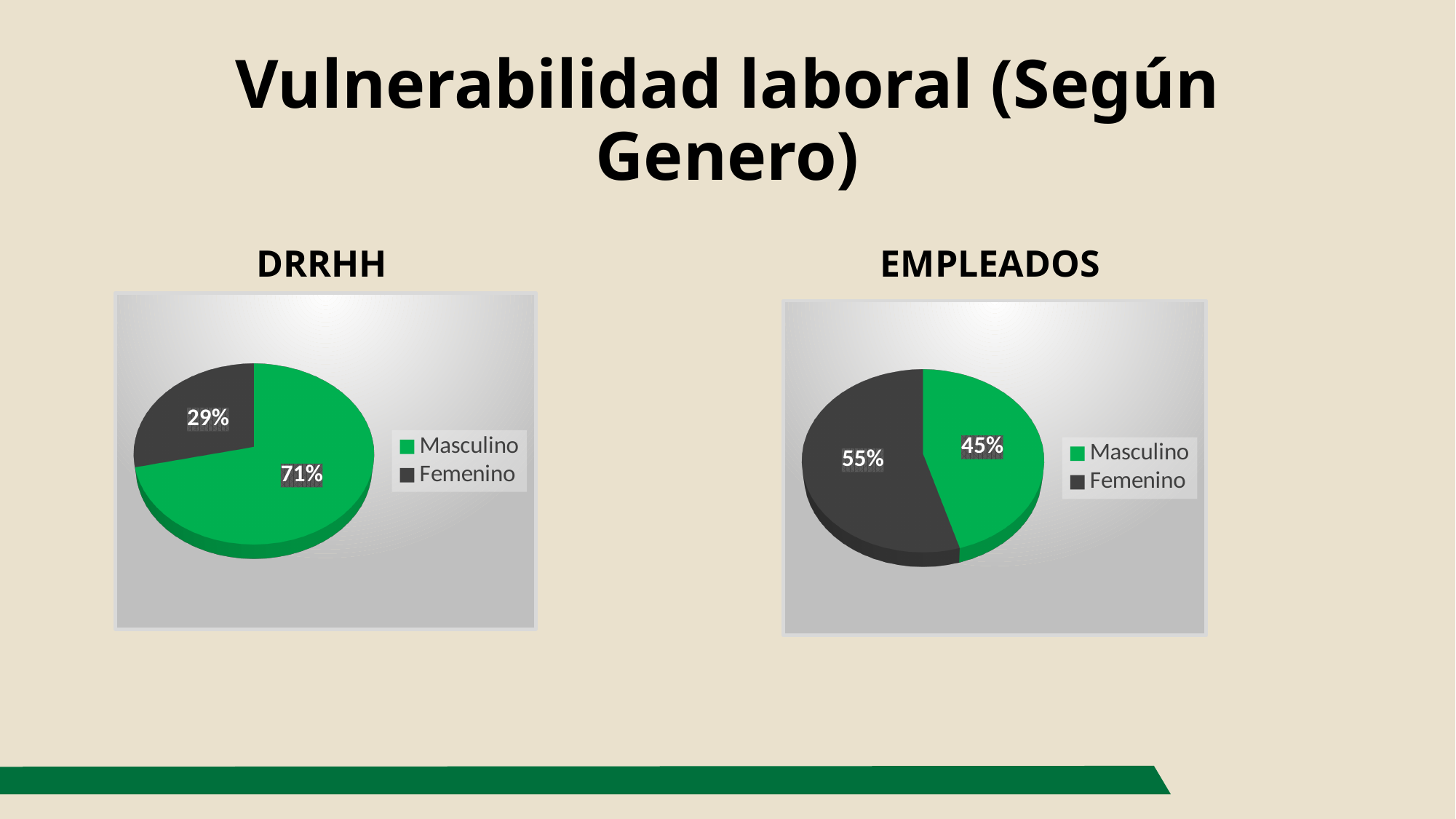
In the EMPLEADOS chart, what is the value for Masculino? 45% In the DRRHH chart, what is the value for Femenino? 29% In the DRRHH chart, what colour represents Femenino? Dark grey In the EMPLEADOS chart, what is the difference between the Femenino and Masculino values? 10% What kind of chart is the DRRHH chart? Pie chart In the DRRHH chart, which category has the largest slice? Masculino In the EMPLEADOS chart, which category has the smallest slice? Masculino How many series does the legend of the EMPLEADOS chart list? 2 In the DRRHH chart, what is the value for Masculino? 71% In the DRRHH chart, what is the difference between the Masculino and Femenino values? 42% In the EMPLEADOS chart, which is larger, Masculino or Femenino? Femenino In the EMPLEADOS chart, what is the value for Femenino? 55%